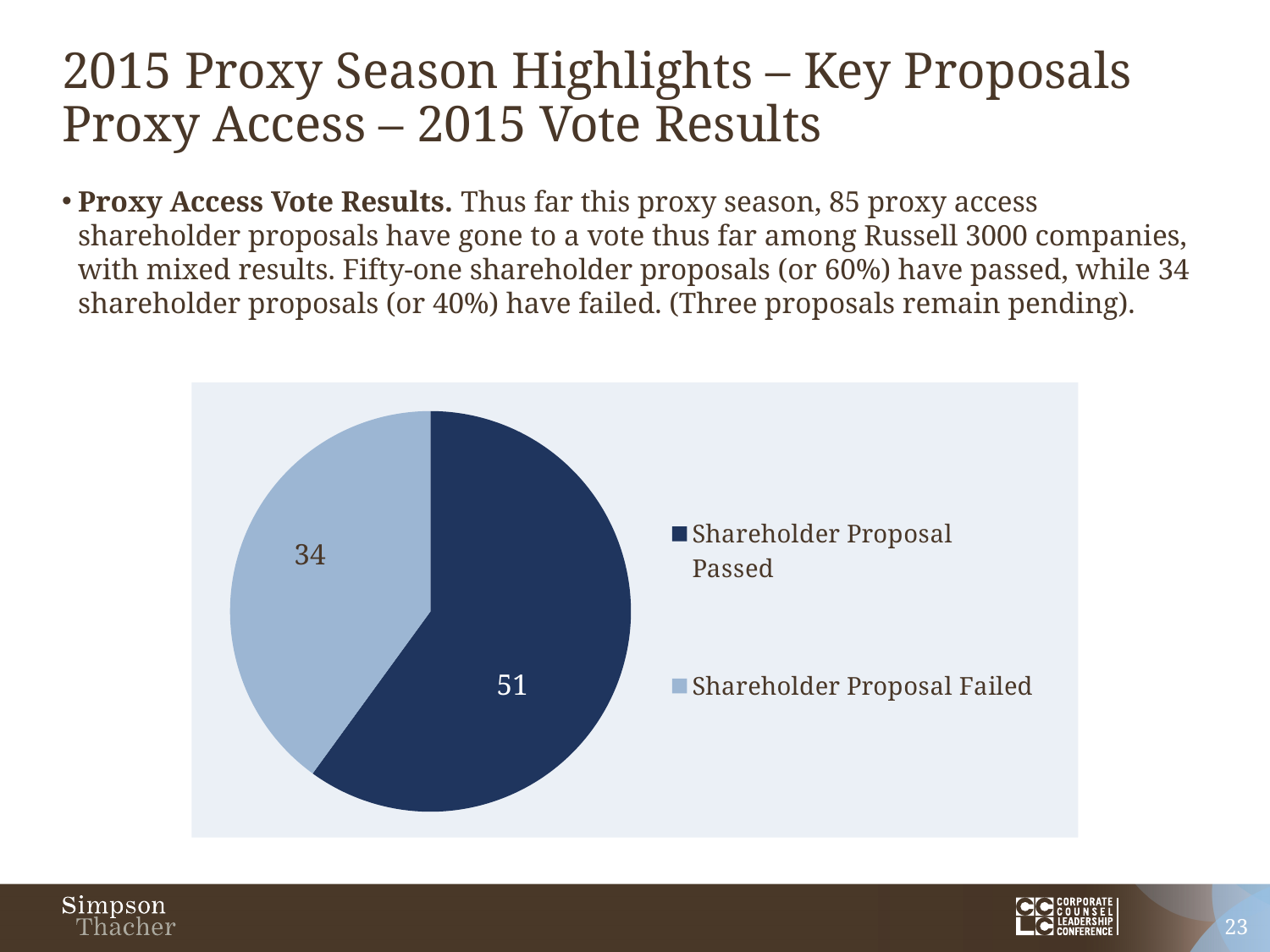
How many proposals are shown for Shareholder Proposal Failed? 34 What is the difference between the number of proposals passed and the number failed? 17 What kind of chart is shown on the slide? Pie chart Which slice of the pie is the smallest? Shareholder Proposal Failed What share of the pie does the Shareholder Proposal Passed slice represent? 60% How many slices does the pie chart have? 2 What colour is the Shareholder Proposal Failed slice? Light blue How many entries does the legend list? 2 What is the total number of proposals represented in the pie chart? 85 Which slice of the pie is the largest? Shareholder Proposal Passed How many proposals are shown for Shareholder Proposal Passed? 51 Which is larger, the Shareholder Proposal Passed slice or the Shareholder Proposal Failed slice? Shareholder Proposal Passed